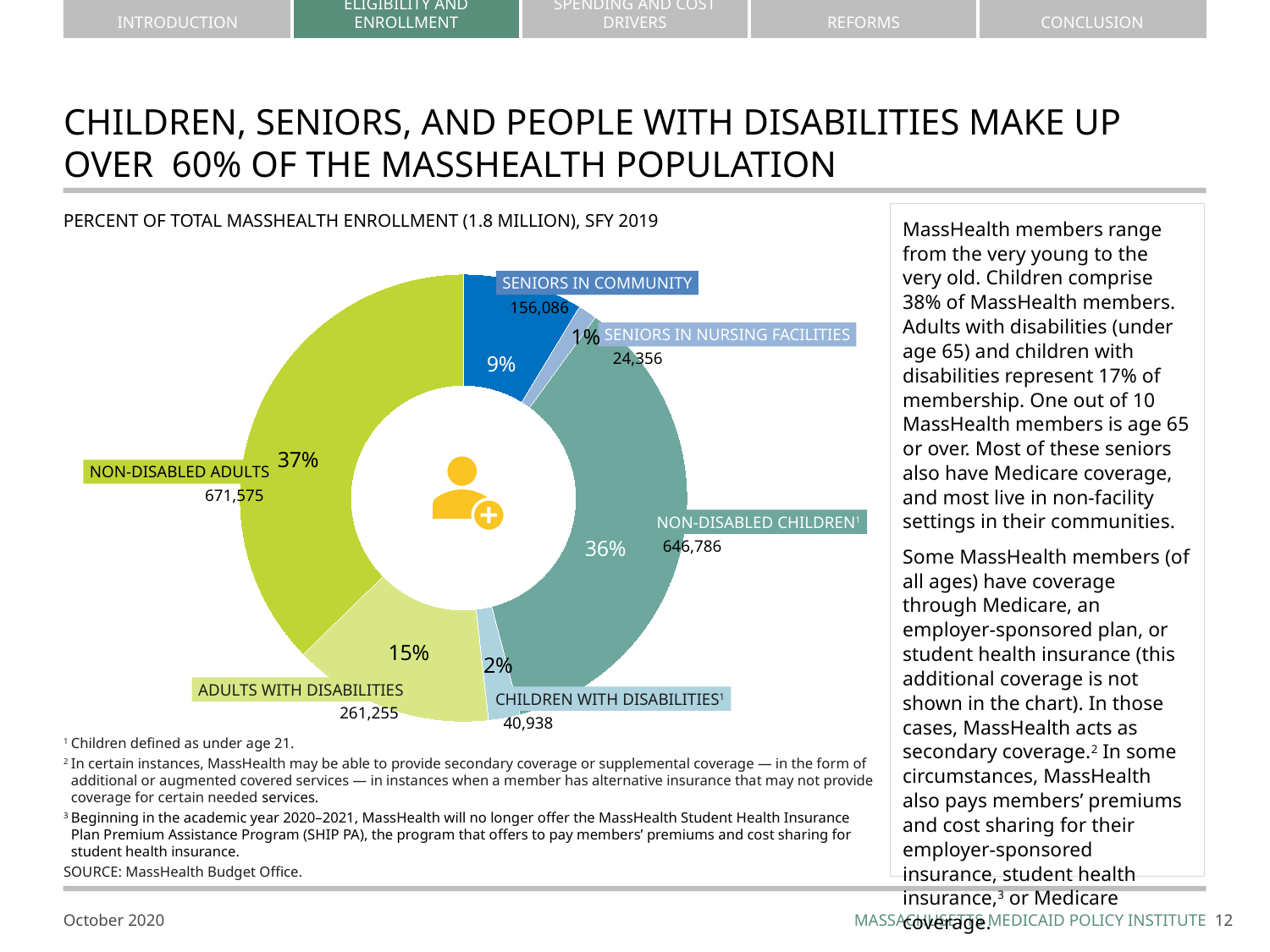
How many categories does the donut chart show? 6 What is the enrollment value for Seniors in Nursing Facilities? 24,356 What is the enrollment value for Non-Disabled Adults? 671,575 Which is larger: the enrollment for Seniors in Community or for Children with Disabilities? Seniors in Community Which category has the smallest enrollment? Seniors in Nursing Facilities Which category has the largest enrollment? Non-Disabled Adults What percentage of total MassHealth enrollment is Adults with Disabilities? 15% What kind of chart is shown on the slide? Pie chart (donut) What is the difference in enrollment between Non-Disabled Adults and Non-Disabled Children? 24,789 What is the combined enrollment of Seniors in Community and Seniors in Nursing Facilities? 180,442 What percentage of total MassHealth enrollment is Non-Disabled Children? 36% What is the subtitle printed above the chart? PERCENT OF TOTAL MASSHEALTH ENROLLMENT (1.8 MILLION), SFY 2019